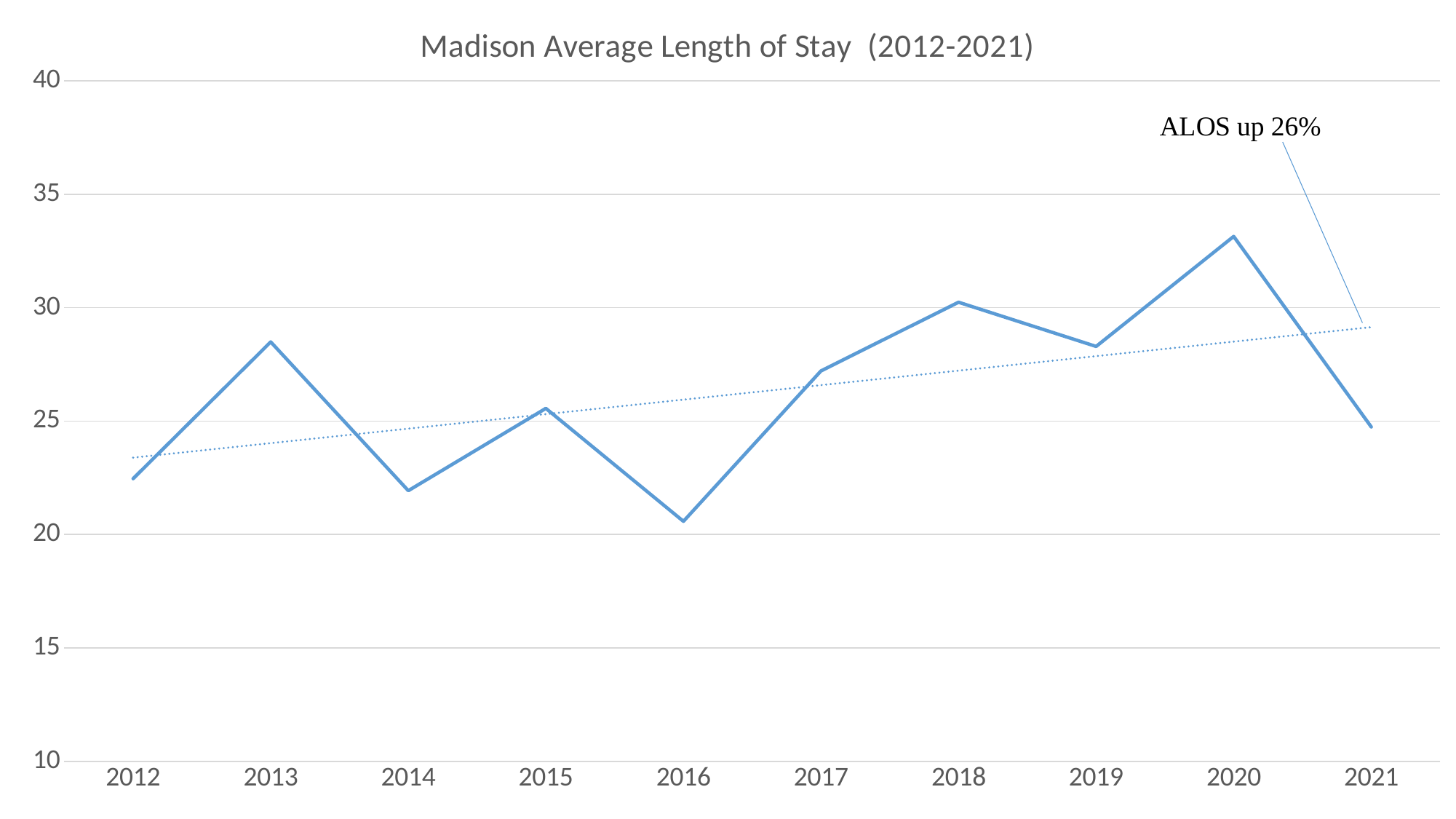
Which year has the lowest average length of stay? 2016 Is the value for 2013 greater or less than 25? greater What does the annotation on the chart say? ALOS up 26% Is the value for 2020 greater or less than 30? greater Which year has the larger value, 2012 or 2020? 2020 Is the value for 2014 greater or less than 25? less How many years are plotted on the x axis? 10 According to the dotted trendline, do values generally rise or fall from 2012 to 2021? rise What is the title of the chart? Madison Average Length of Stay (2012-2021) Which year has the highest average length of stay? 2020 What kind of chart is shown on the slide? line chart